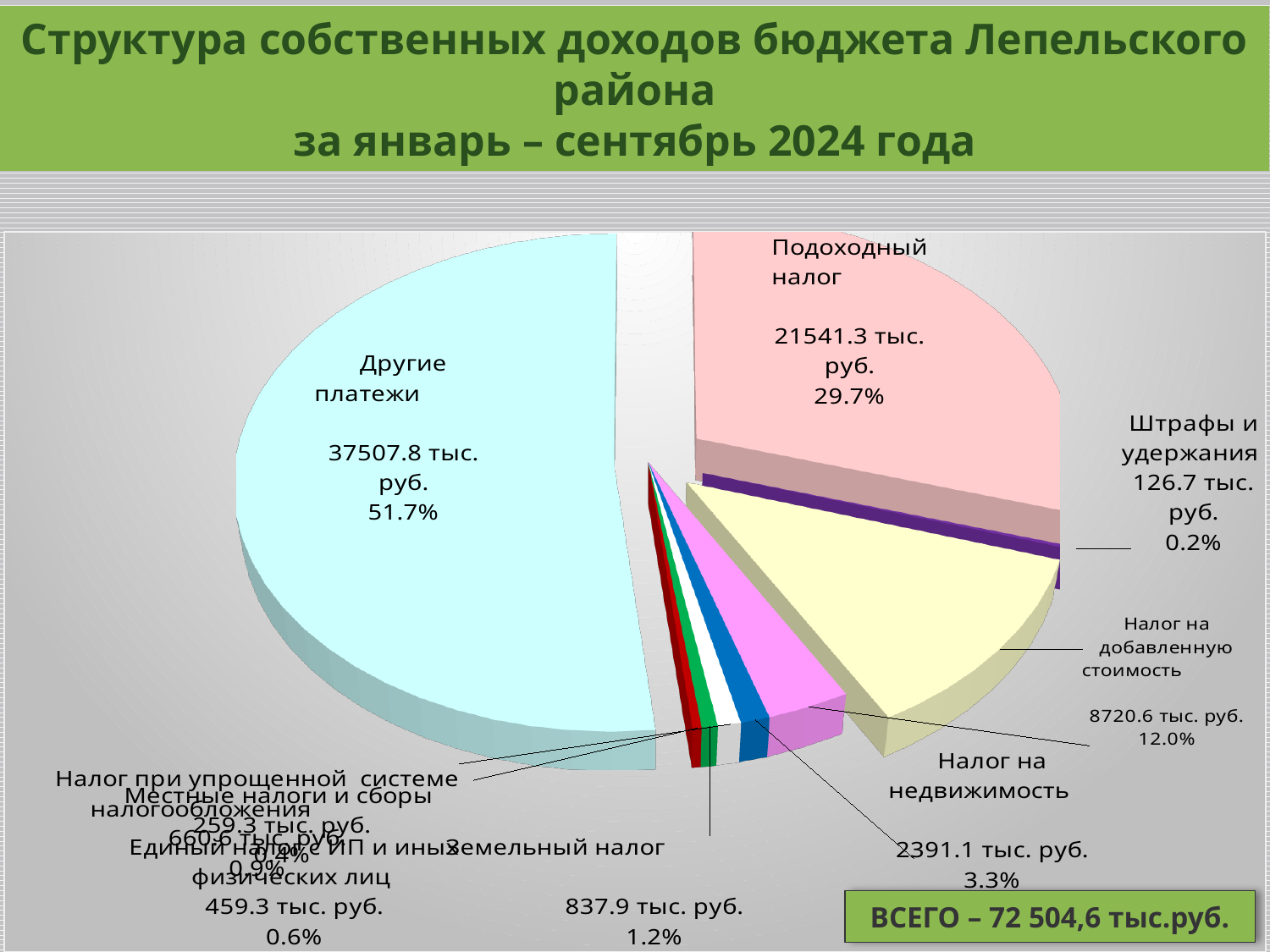
What percentage is shown for Налог на добавленную стоимость? 12.0% Which category has the smallest slice of the pie? Штрафы и удержания What is the value for Штрафы и удержания? 126.7 тыс. руб. What is the difference in percentage points between Подоходный налог and Налог на добавленную стоимость? 17.7 What is the percentage shown for Земельный налог? 1.2% What is the value for Подоходный налог? 21541.3 тыс. руб. What type of chart is shown on the slide? pie chart Which category has the largest slice of the pie? Другие платежи What share of the pie does Другие платежи represent? 51.7% What total value is stated on the slide (ВСЕГО)? 72 504,6 тыс.руб. What is the value for Налог на недвижимость? 2391.1 тыс. руб. Which is larger: Земельный налог or Единый налог с ИП и иных физических лиц? Земельный налог